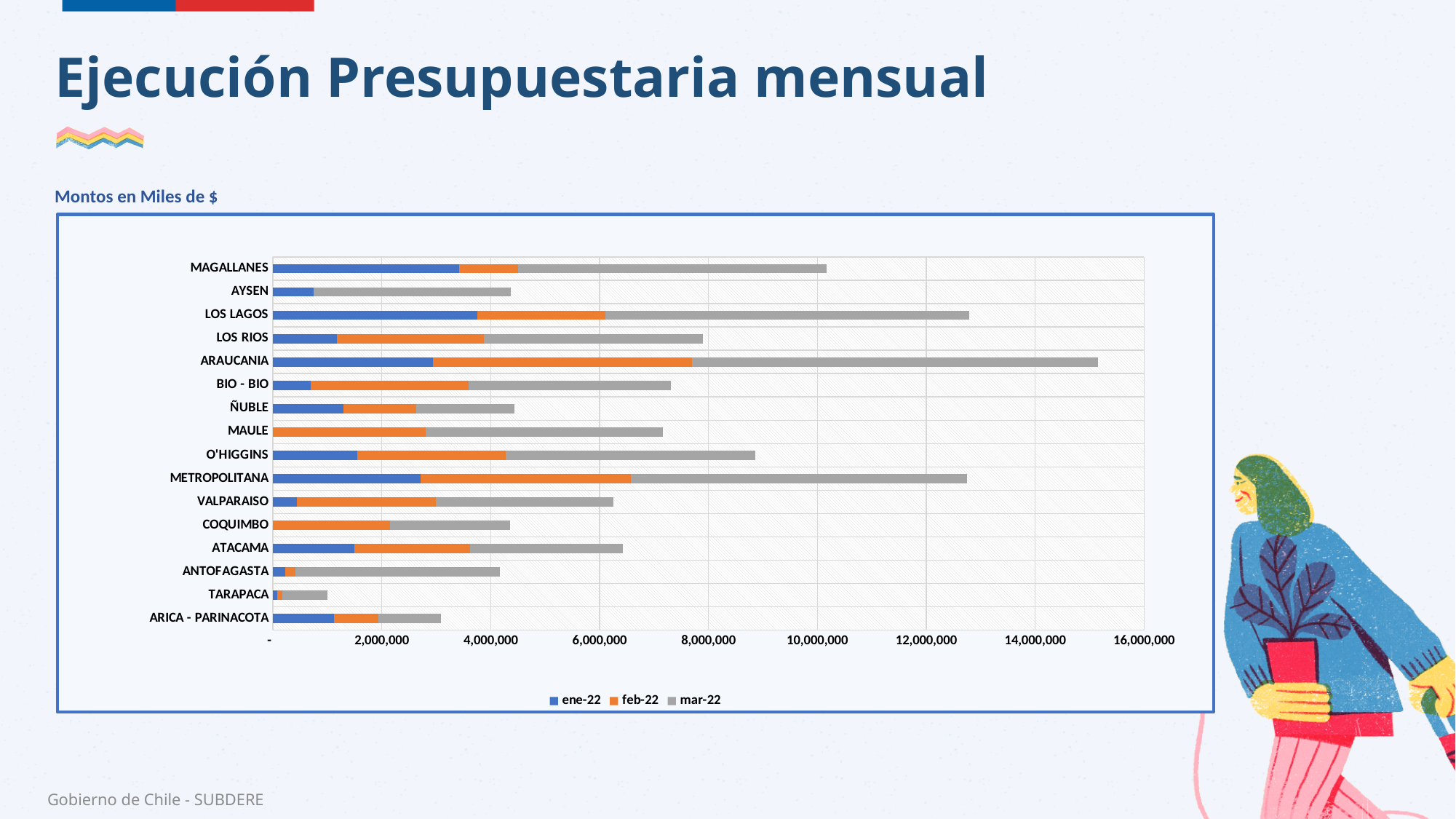
Which region has the highest total bar on the chart? ARAUCANIA Which region has the larger total bar, ARAUCANIA or METROPOLITANA? ARAUCANIA What kind of chart is shown on the slide? Stacked bar chart Is the total bar for AYSEN greater or less than 6,000,000? less Is the total bar for ARAUCANIA greater or less than 14,000,000? greater How many series does the chart legend list? 3 Is the total bar for TARAPACA greater or less than 2,000,000? less Which region has the larger total bar, MAULE or COQUIMBO? MAULE What are the three series names listed in the chart legend? ene-22, feb-22, mar-22 How many regions (categories) are plotted on the chart? 16 Which region has the lowest total bar on the chart? TARAPACA